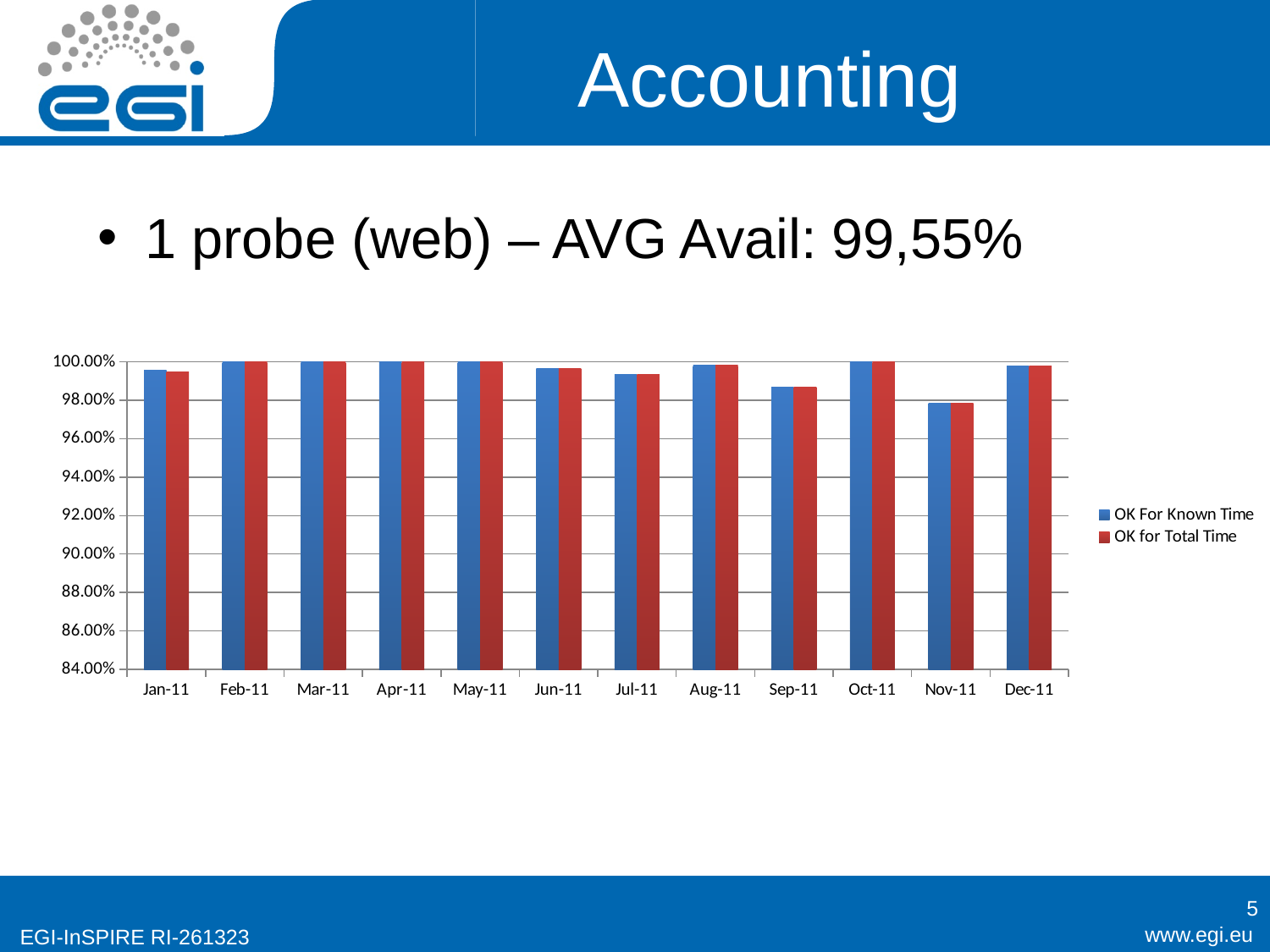
Is the OK For Known Time value for Nov-11 greater or less than 96.00%? greater How many months are shown on the x axis of the chart? 12 Which is larger, the OK For Known Time value for Sep-11 or for Nov-11? Sep-11 Which is larger, the OK for Total Time value for Jan-11 or for Nov-11? Jan-11 Which month has the lowest value for OK for Total Time? Nov-11 How many series does the chart legend list? 2 Is the OK For Known Time value for Sep-11 greater or less than 98.00%? greater What are the two series named in the chart legend? OK For Known Time and OK for Total Time What colour are the bars for the OK for Total Time series? red Is the OK for Total Time value for Jul-11 greater or less than 98.00%? greater Which month has the lowest value for OK For Known Time? Nov-11 What kind of chart is shown on the slide? bar chart